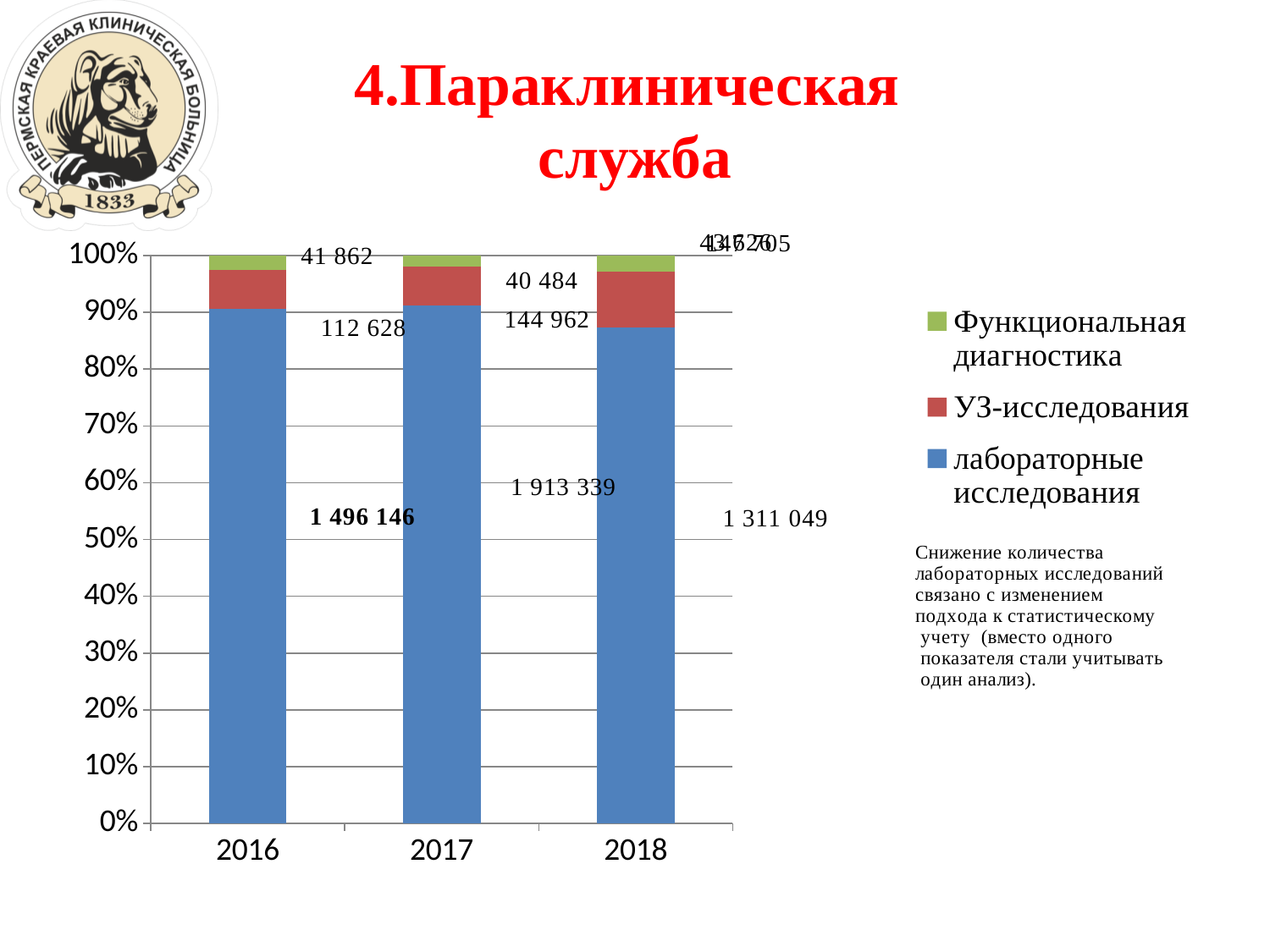
What is the value for лабораторные исследования in 2016? 1 496 146 Is the share of лабораторные исследования in the 2018 bar greater or less than 90%? less In which year is the value for лабораторные исследования the highest? 2017 How many years are shown on the x axis? 3 Which year has the larger value for УЗ-исследования, 2016 or 2017? 2017 What is the difference between the лабораторные исследования values for 2017 and 2016? 417 193 How many series does the legend list? 3 What is the value for УЗ-исследования in 2016? 112 628 What kind of chart is shown on the slide? stacked bar chart What is the value for лабораторные исследования in 2017? 1 913 339 What is the value for Функциональная диагностика in 2017? 40 484 What is the value for лабораторные исследования in 2018? 1 311 049